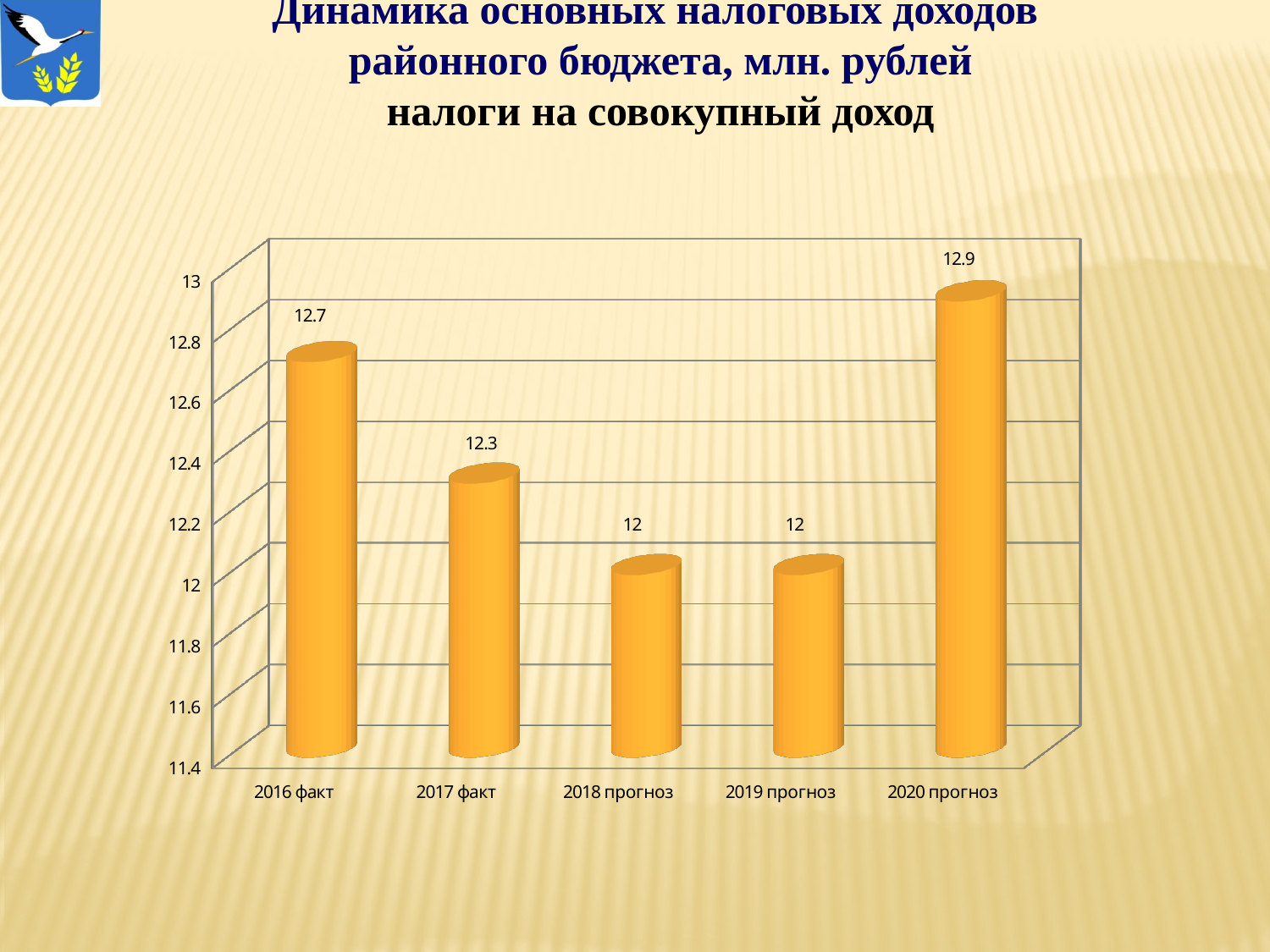
What is the value for 2017 факт? 12.3 Do the values rise or fall from 2016 факт to 2018 прогноз? fall Which category has the highest value? 2020 прогноз What is the difference between the values for 2020 прогноз and 2016 факт? 0.2 What is the value for 2018 прогноз? 12 What is the value for 2016 факт? 12.7 What is the value for 2020 прогноз? 12.9 How many categories are shown on the x axis? 5 What kind of chart is shown on the slide? bar chart What is the difference between the values for 2016 факт and 2017 факт? 0.4 Is the value for 2020 прогноз greater or less than 12.8? greater Which is larger, the value for 2017 факт or the value for 2019 прогноз? 2017 факт